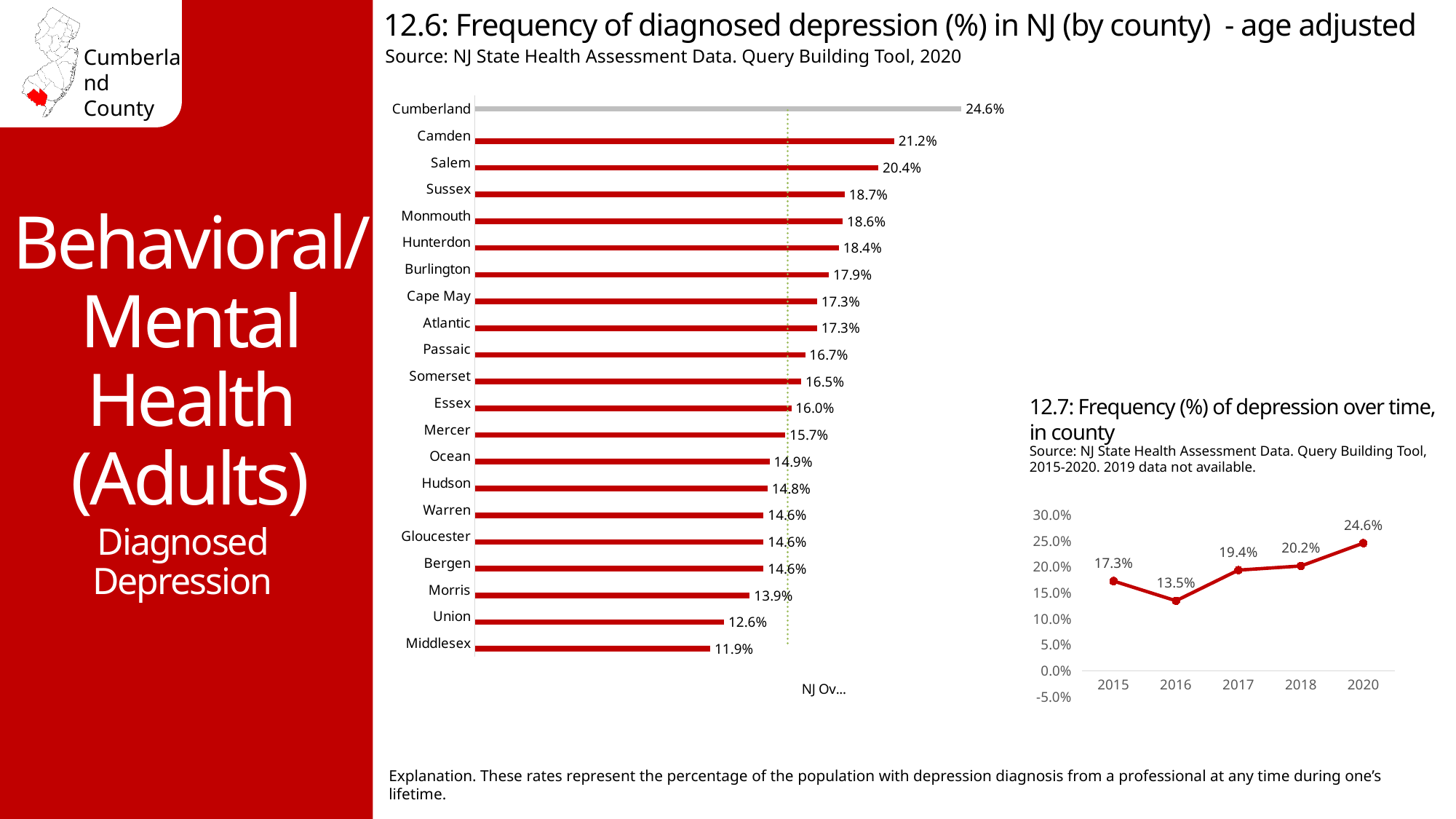
In chart 12.7 (Frequency of depression over time, in county), which year has the highest value? 2020 In chart 12.6 (Frequency of diagnosed depression by county), what is the value for Cumberland? 24.6% In chart 12.6 (Frequency of diagnosed depression by county), which county has the highest value? Cumberland In chart 12.7 (Frequency of depression over time, in county), what is the value for 2016? 13.5% In chart 12.6 (Frequency of diagnosed depression by county), what is the difference between Cumberland and Camden? 3.4% In chart 12.6 (Frequency of diagnosed depression by county), which is larger, the value for Sussex or the value for Hunterdon? Sussex What kind of chart is chart 12.6 (Frequency of diagnosed depression by county)? Bar chart In chart 12.6 (Frequency of diagnosed depression by county), what is the value for Salem? 20.4% In chart 12.7 (Frequency of depression over time, in county), how many data points are plotted? 5 In chart 12.6 (Frequency of diagnosed depression by county), how many counties are plotted? 21 In chart 12.7 (Frequency of depression over time, in county), what is the difference between the 2020 and 2015 values? 7.3% In chart 12.6 (Frequency of diagnosed depression by county), which county has the lowest value? Middlesex